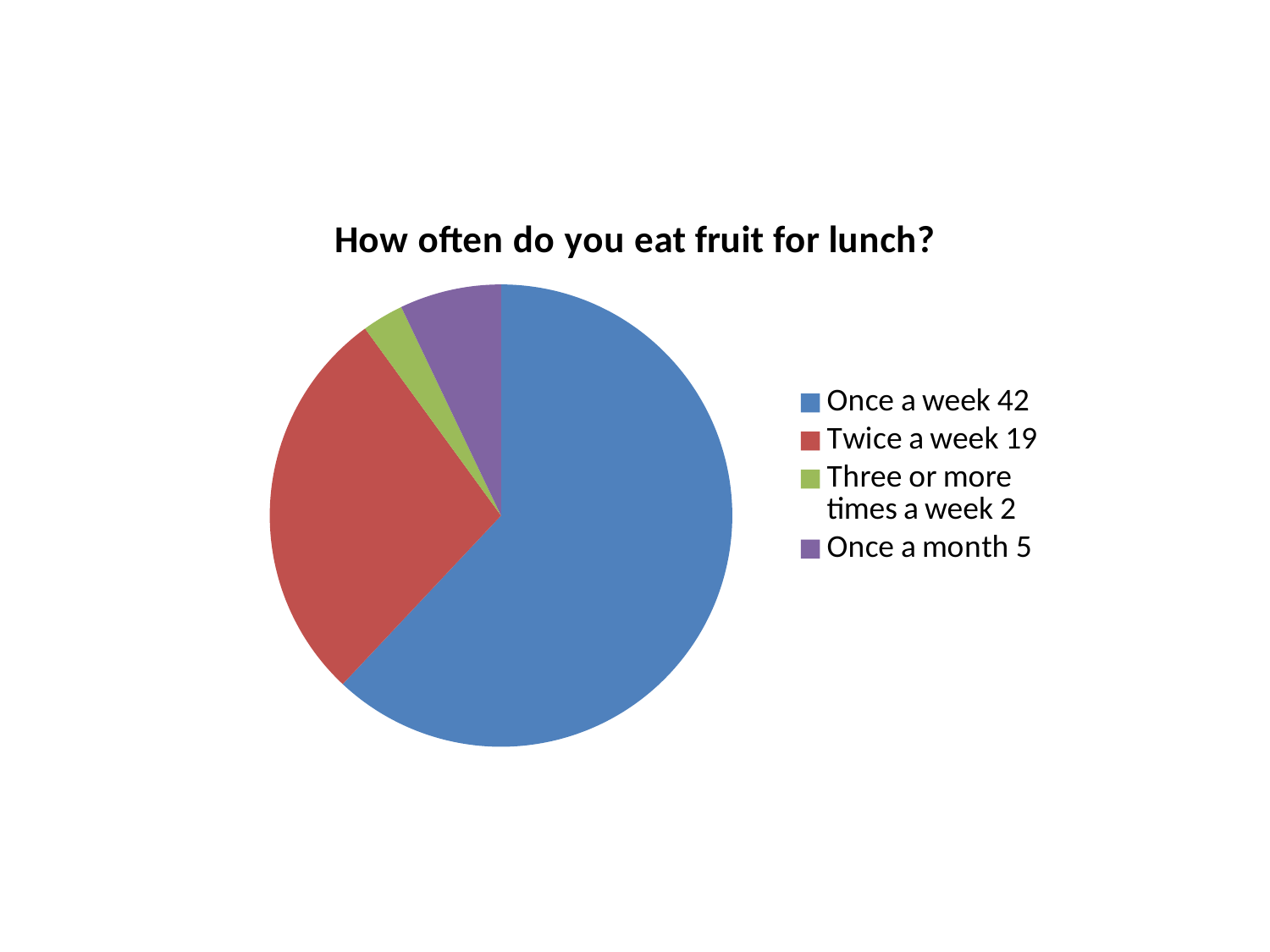
What is the difference between the values for "Once a week" and "Twice a week"? 23 What is the value for "Once a month"? 5 What is the total of all four values in the pie chart? 68 Which is larger, the value for "Once a month" or the value for "Three or more times a week"? Once a month What is the value for "Once a week"? 42 What is the title of the chart? How often do you eat fruit for lunch? How many slices does the pie chart have? 4 What is the value for "Three or more times a week"? 2 What type of chart is shown on the slide? Pie chart What is the value for "Twice a week"? 19 Which category has the smallest slice? Three or more times a week Which category has the largest slice? Once a week